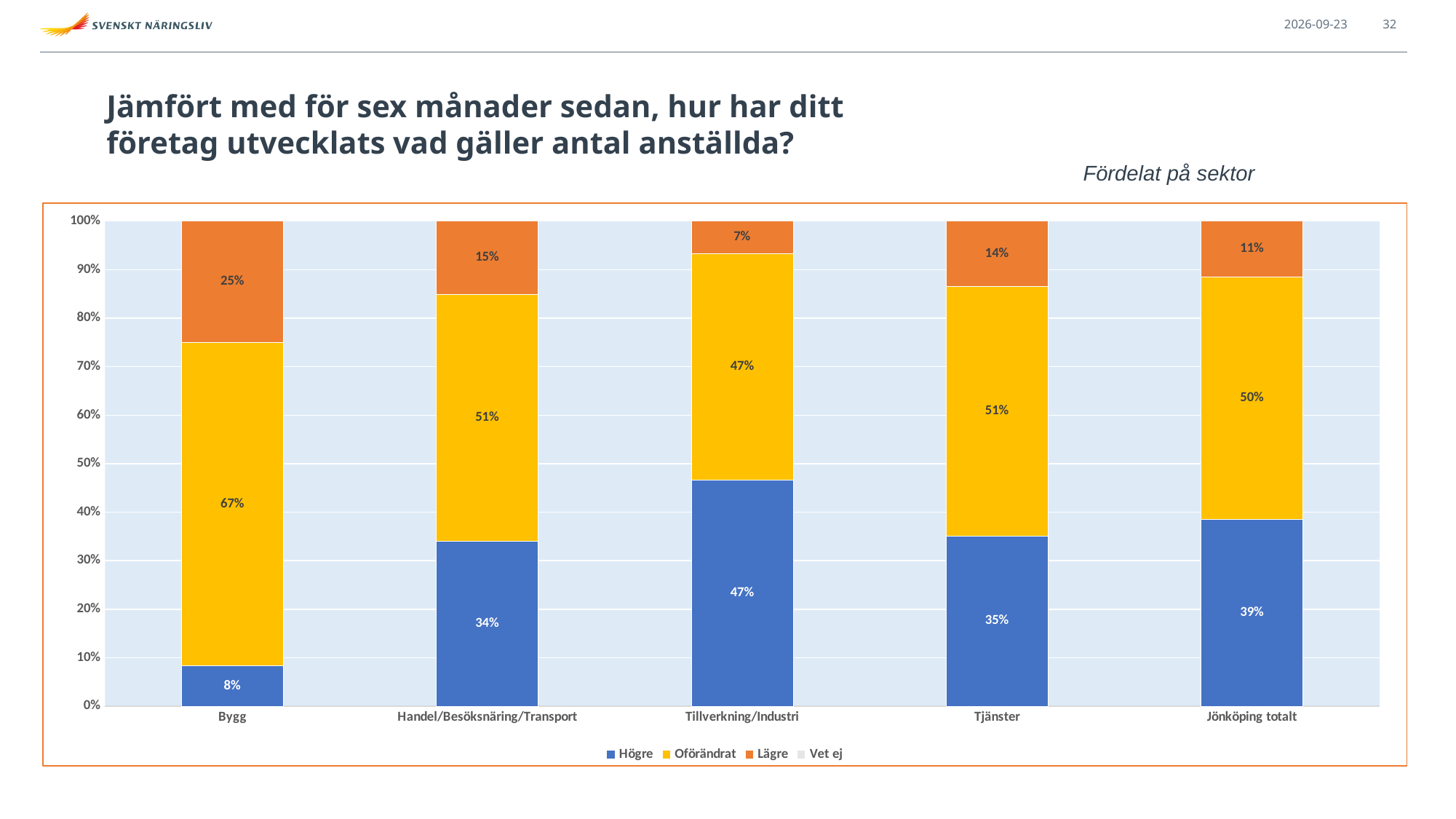
What is the Högre value for Jönköping totalt? 39% What is the Oförändrat share for Handel/Besöksnäring/Transport? 51% What is the difference between the Lägre values for Bygg and Tjänster? 11 percentage points Which sector has the lowest Lägre share? Tillverkning/Industri Which is larger, the Högre value for Tjänster or for Handel/Besöksnäring/Transport? Tjänster What percentage of companies in Bygg answered Högre? 8% Which sector has the highest Högre share? Tillverkning/Industri What kind of chart is shown on the slide? Stacked bar chart Which sector has the highest Lägre share? Bygg How many sectors are shown on the x axis? 5 How many series does the legend list? 4 What is the Lägre value for Tillverkning/Industri? 7%